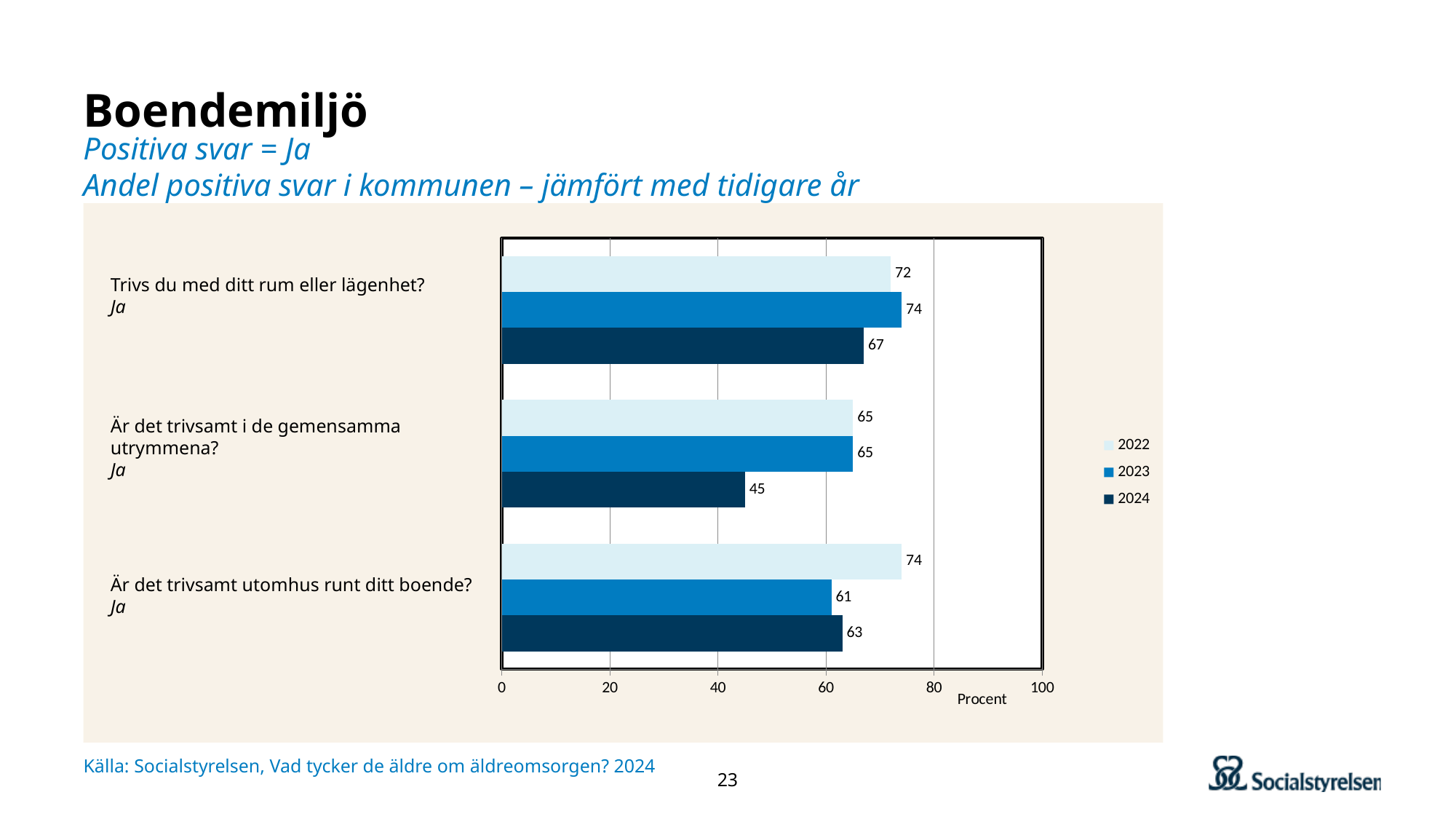
For "Är det trivsamt utomhus runt ditt boende?", which year has the larger value, 2023 or 2024? 2024 What is the label on the horizontal axis of the chart? Procent Which question has the highest 2023 value? Trivs du med ditt rum eller lägenhet? What is the difference between the 2023 and 2024 values for "Är det trivsamt i de gemensamma utrymmena?"? 20 How many series does the legend list? 3 Is the 2024 value for "Trivs du med ditt rum eller lägenhet?" greater or less than 60? greater What kind of chart is shown on the slide? Bar chart What is the 2023 value for "Trivs du med ditt rum eller lägenhet?"? 74 How many questions (categories) are shown in the chart? 3 What is the 2024 value for "Är det trivsamt i de gemensamma utrymmena?"? 45 Which question has the lowest 2024 value? Är det trivsamt i de gemensamma utrymmena? What is the 2022 value for "Är det trivsamt utomhus runt ditt boende?"? 74